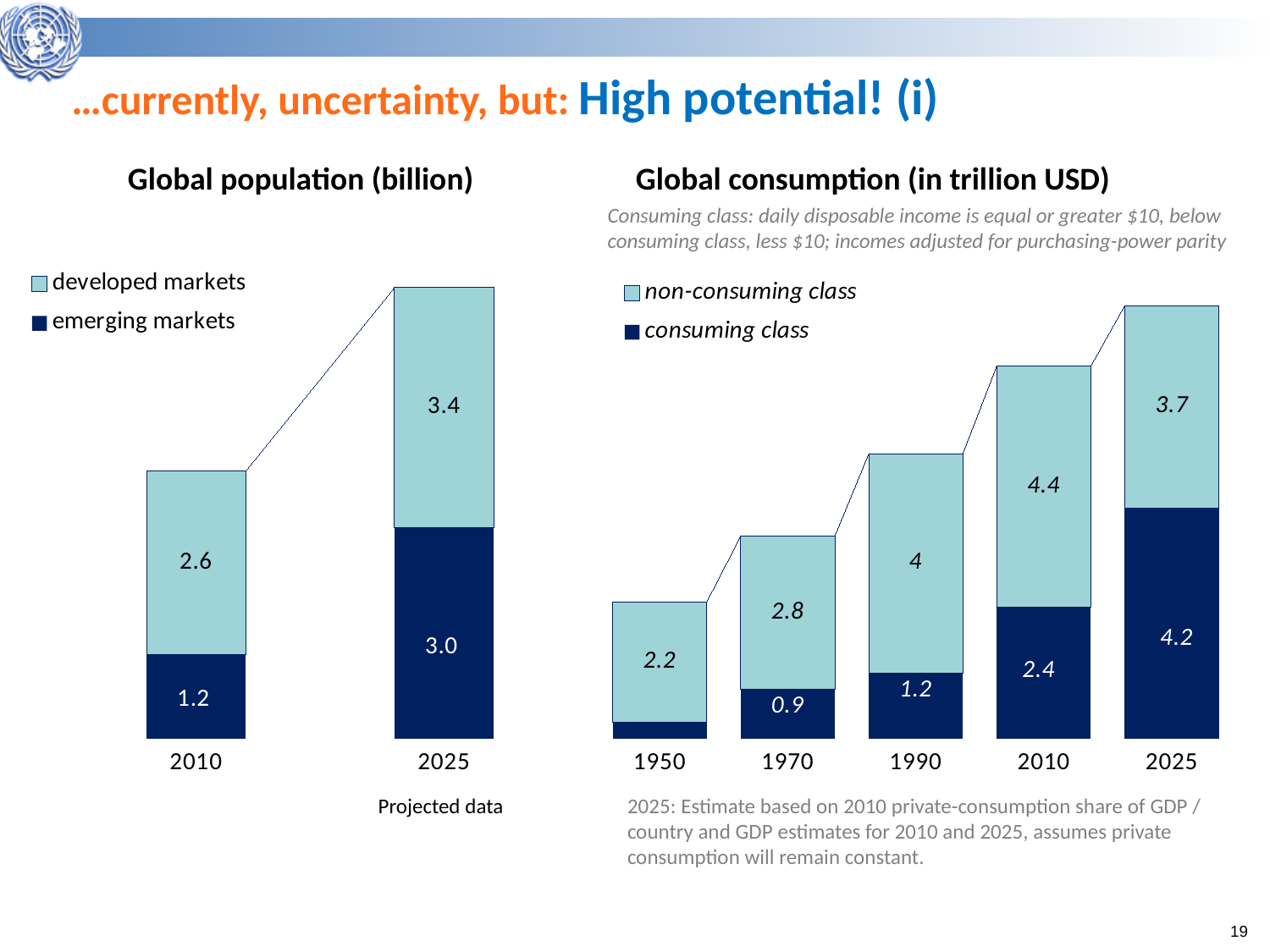
In the Global population (billion) chart, how many series does the legend list? 2 In the Global population (billion) chart, what is the value for emerging markets in 2010? 1.2 In the Global population (billion) chart, what is the total of the stacked bar for 2025? 6.4 In the Global consumption (in trillion USD) chart, is the consuming class value larger in 2025 or the non-consuming class value in 2025? consuming class In the Global consumption (in trillion USD) chart, what is the value for the non-consuming class in 1990? 4 In the Global population (billion) chart, what is the difference between the emerging markets values for 2025 and 2010? 1.8 In the Global consumption (in trillion USD) chart, which year has the highest consuming class value? 2025 What kind of chart is the Global consumption (in trillion USD) chart? stacked bar chart In the Global population (billion) chart, what is the value for developed markets in 2025? 3.4 In the Global consumption (in trillion USD) chart, what is the total of the stacked bar for 2025? 7.9 In the Global consumption (in trillion USD) chart, how many years are shown on the x axis? 5 In the Global consumption (in trillion USD) chart, what is the value for the consuming class in 2010? 2.4